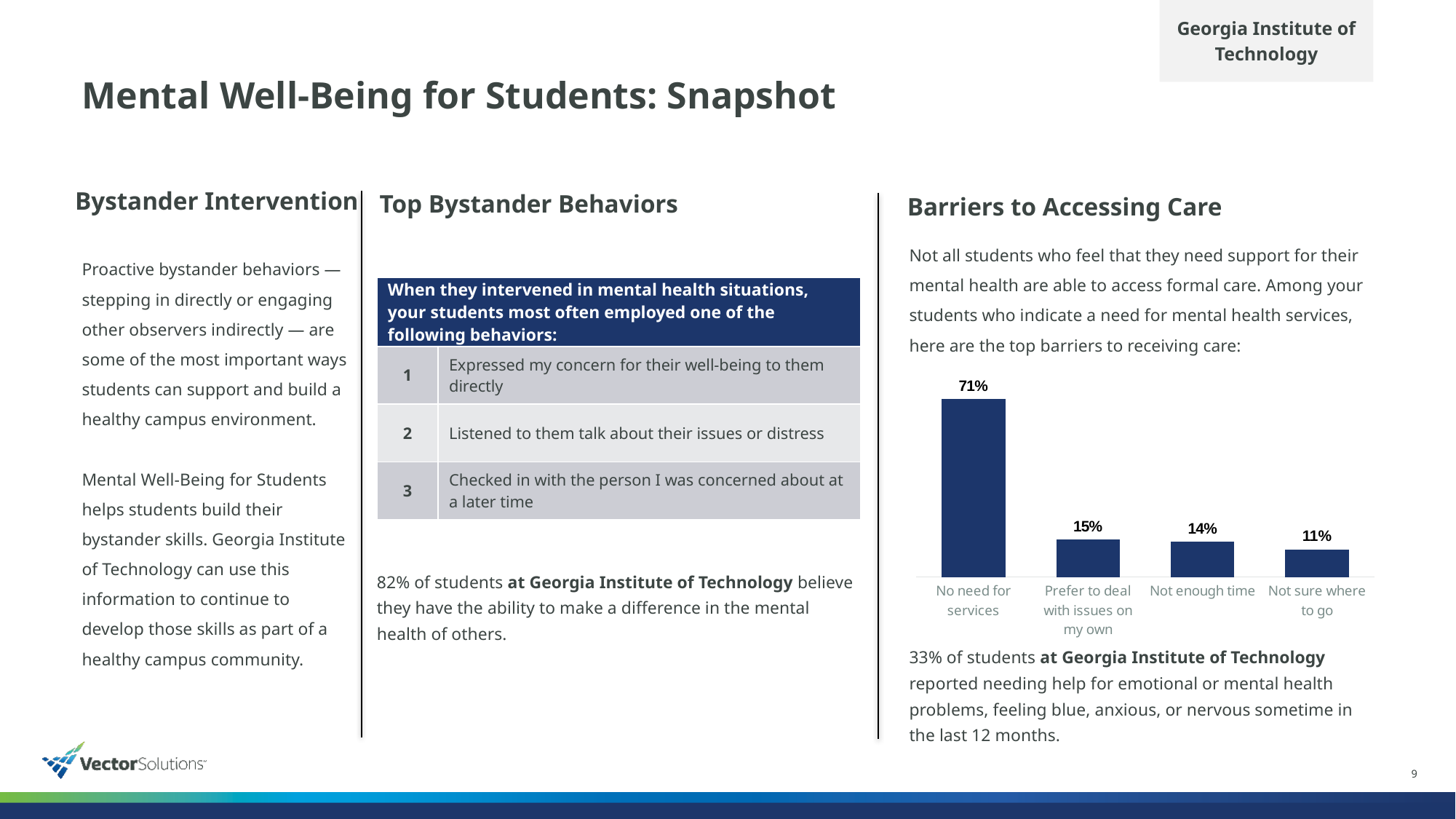
What is the value for "Not sure where to go" in the barriers chart? 11% What type of chart is used to show the barriers to accessing care? Bar chart What is the difference between the values for "Not enough time" and "Not sure where to go"? 3% What is the difference between the values for "No need for services" and "Prefer to deal with issues on my own"? 56% What is the value for "Not enough time" in the barriers chart? 14% How many barrier categories are shown in the chart? 4 What percentage of students cited "No need for services" as a barrier to accessing care? 71% Which barrier has the highest value in the chart? No need for services Which barrier has the lowest value in the chart? Not sure where to go Which is larger: the value for "Prefer to deal with issues on my own" or the value for "Not sure where to go"? Prefer to deal with issues on my own What is the value for "Prefer to deal with issues on my own" in the barriers chart? 15% Do the values in the barriers chart rise or fall from left to right? Fall